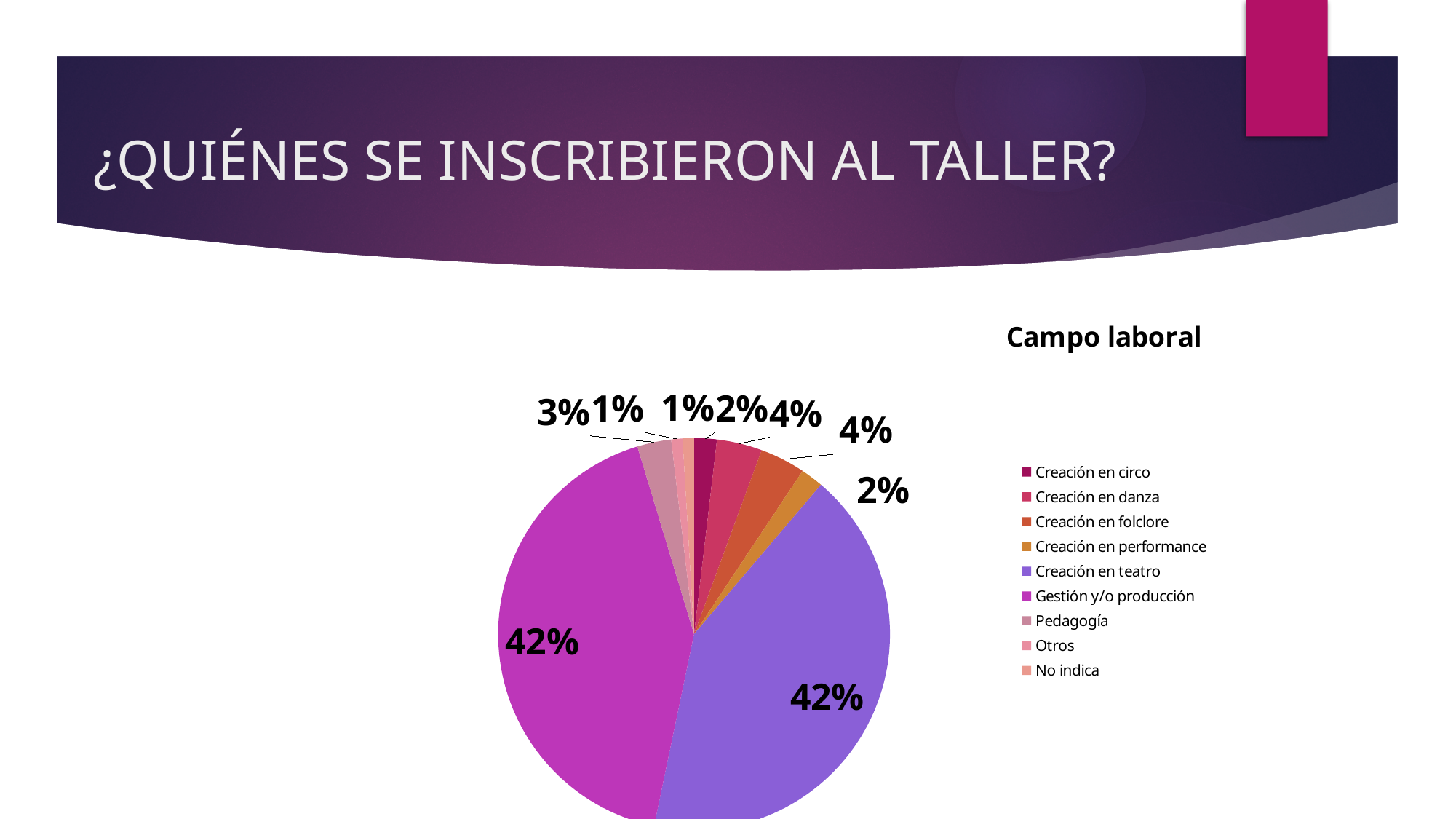
What share of the pie does Creación en teatro represent? 42% What is the title of the chart? Campo laboral What percentage is shown for Creación en folclore? 4% What percentage is shown for Creación en danza? 4% What percentage is shown for Pedagogía? 3% Which legend entry is listed first in the chart's legend? Creación en circo What is the difference between the share for Gestión y/o producción and the share for Pedagogía? 39% What is the combined share of Creación en teatro and Gestión y/o producción? 84% Which is larger, the slice for Creación en teatro or the slice for Pedagogía? Creación en teatro How many categories does the legend of the pie chart list? 9 What share of the pie does Gestión y/o producción represent? 42% What type of chart is shown on the slide? pie chart